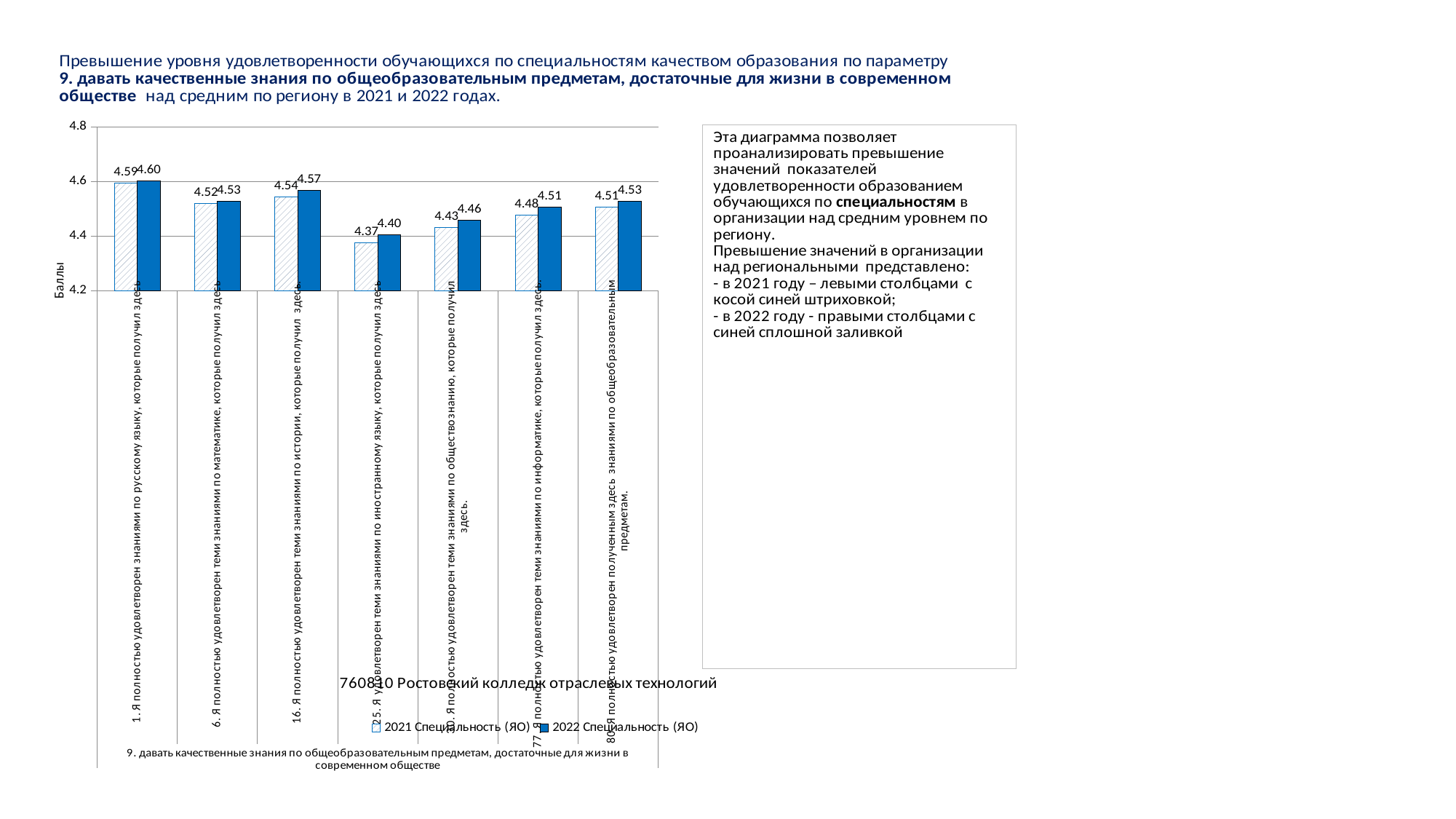
Which statement has the highest 2022 value? 1. Я полностью удовлетворен знаниями по русскому языку, которые получил здесь How many series does the chart legend list? 2 What is the 2022 value for the statement about knowledge of informatics (информатике)? 4.51 What type of chart is shown on the slide? bar chart Which is larger: the 2021 value for mathematics (математике) or the 2021 value for informatics (информатике)? 2021 value for mathematics (4.52) What are the two legend entries of the chart? 2021 Специальность (ЯО); 2022 Специальность (ЯО) What is the 2021 value for the statement about knowledge of history (истории)? 4.54 How many categories (statements) are plotted on the x axis? 7 What is the 2022 value for the statement about knowledge of Russian language (русскому языку)? 4.60 Which statement has the lowest 2021 value? 25. Я удовлетворен теми знаниями по иностранному языку, которые получил здесь What is the difference between the 2022 and 2021 values for the statement about knowledge of social studies (обществознанию)? 0.03 What is the 2021 value for the statement about knowledge of foreign language (иностранному языку)? 4.37